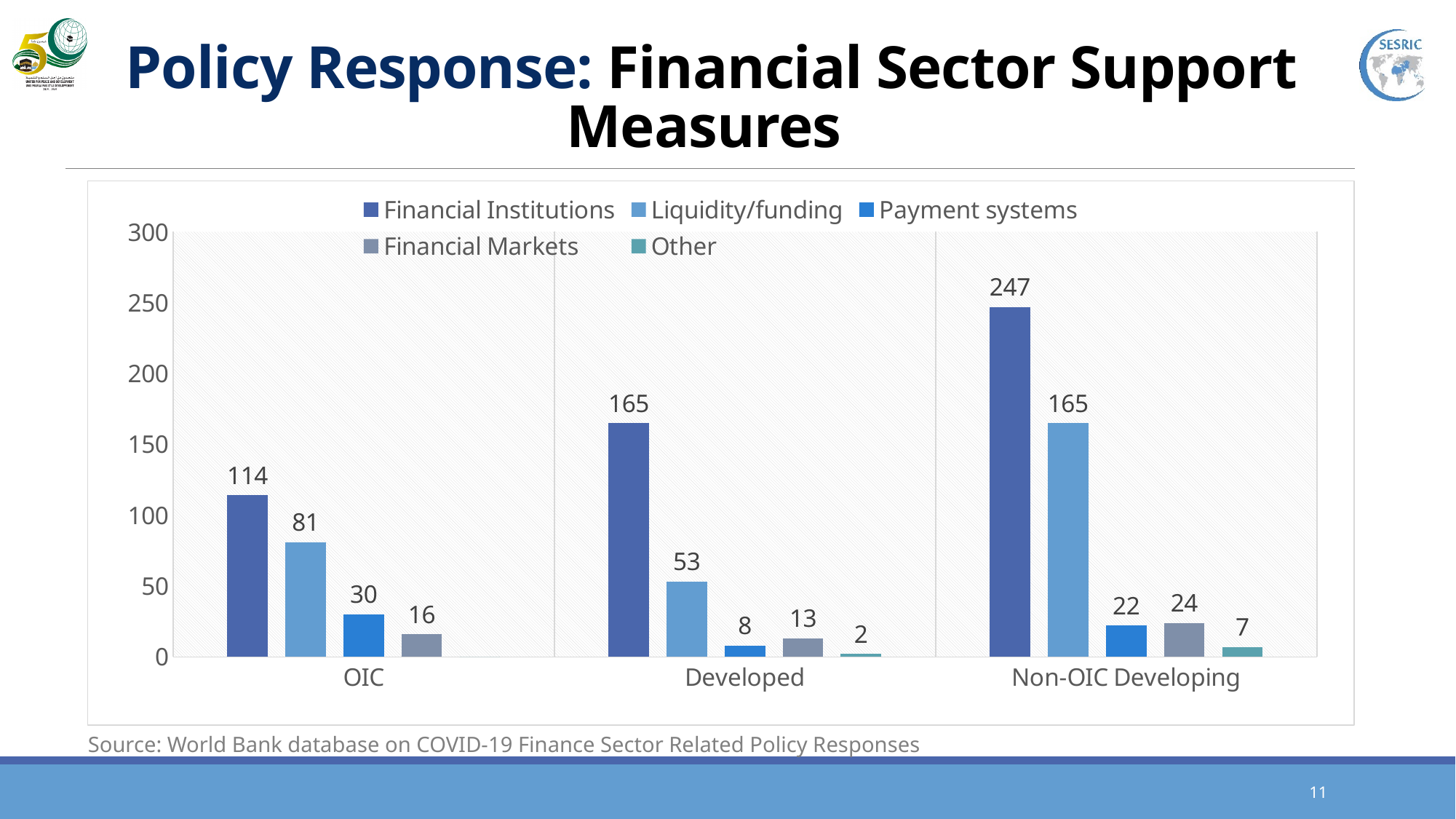
Which group has the lowest value for Liquidity/funding? OIC How many groups are shown on the x axis? 3 What is the value for Liquidity/funding in the OIC group? 81 Is the value for Liquidity/funding in the Developed group greater or less than 100? less What is the difference between the Financial Institutions values for Non-OIC Developing and Developed? 82 How many series does the legend list? 5 What is the value for Payment systems in the Developed group? 8 What kind of chart is shown on the slide? Bar chart What is the value for Financial Institutions in the Non-OIC Developing group? 247 Which is larger: Payment systems for OIC or Payment systems for Non-OIC Developing? OIC Which group has the highest value for Financial Institutions? Non-OIC Developing What is the value for Financial Markets in the Non-OIC Developing group? 24